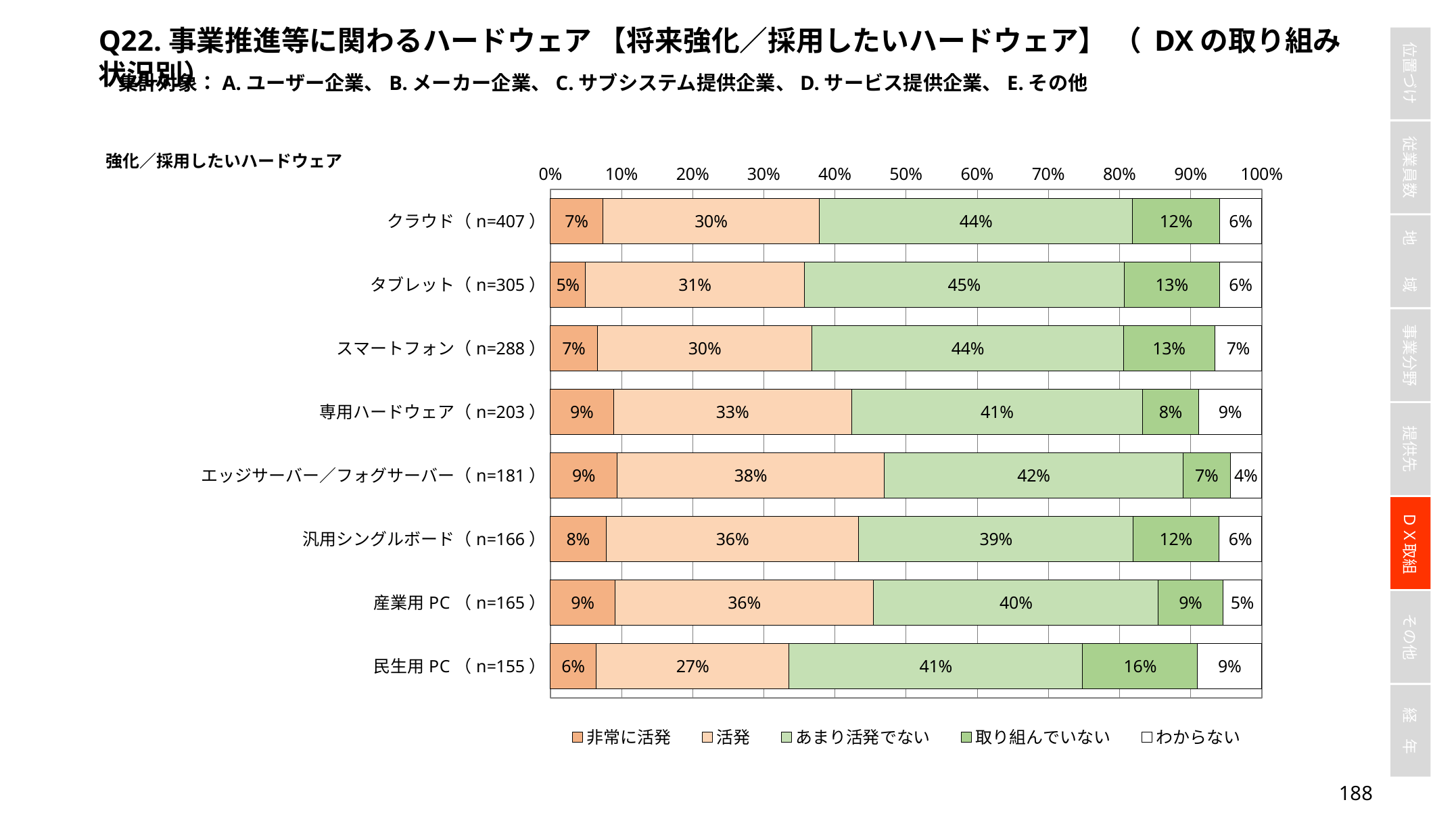
How many hardware categories are shown in the chart? 8 What is the 取り組んでいない share for 民生用 PC（n=155）? 16% What percentage of クラウド（n=407） respondents answered 非常に活発? 7% Which hardware category has the highest 取り組んでいない percentage? 民生用 PC（n=155） What kind of chart is shown on the slide? Stacked horizontal bar chart How many series does the legend list? 5 What is the difference in percentage points between the あまり活発でない share for タブレット（n=305） and for 汎用シングルボード（n=166）? 6 percentage points Which hardware category has the highest 活発 percentage? エッジサーバー／フォグサーバー（n=181） What is the combined share of 非常に活発 and 活発 for エッジサーバー／フォグサーバー（n=181）? 47% Which has a larger 活発 share: 専用ハードウェア（n=203） or 産業用 PC（n=165）? 産業用 PC（n=165） What is the first entry in the chart legend? 非常に活発 Which hardware category has the lowest 活発 percentage? 民生用 PC（n=155）